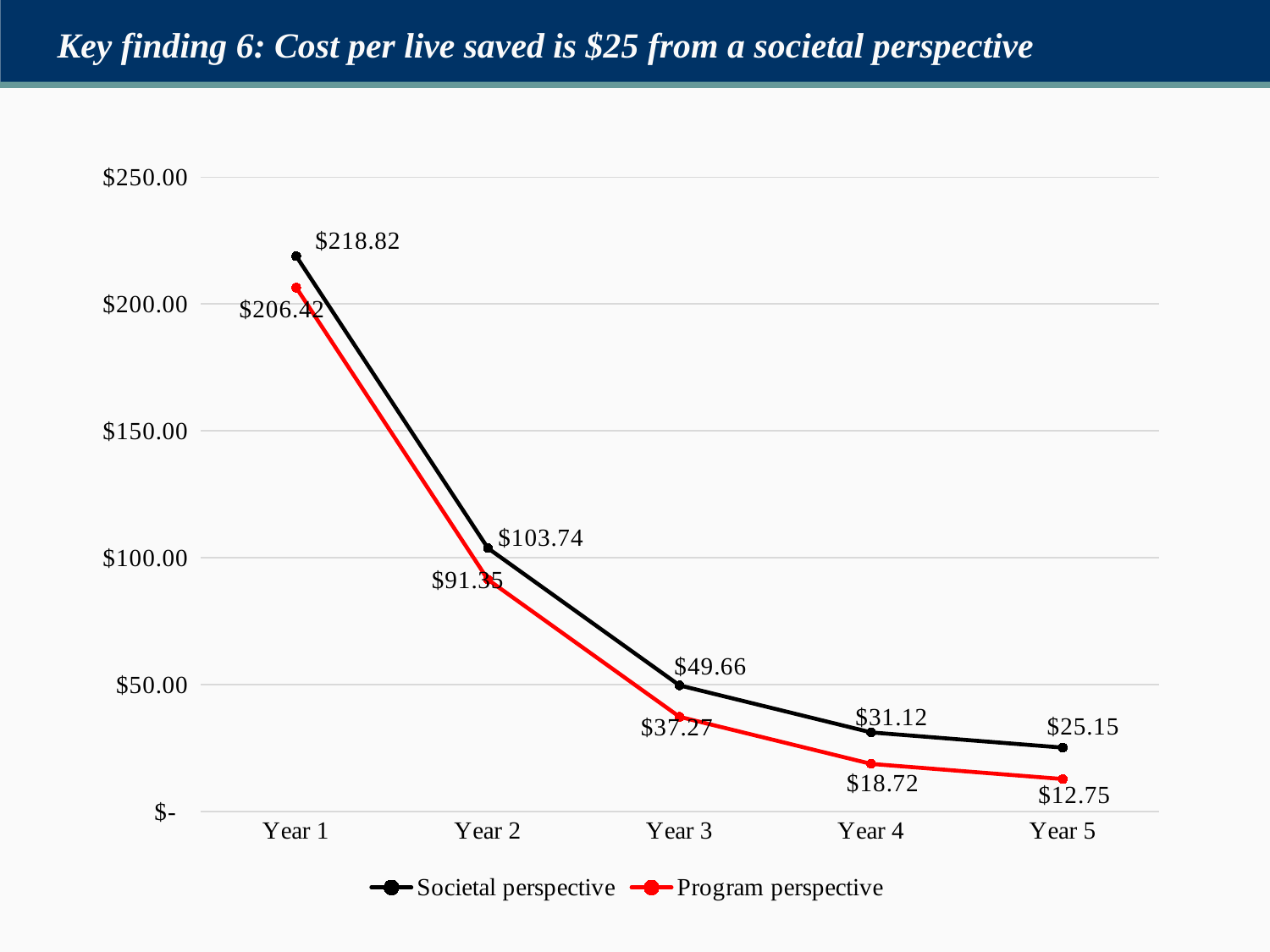
In which year is the Program perspective value lowest? Year 5 What is the Program perspective value in Year 5? $12.75 In which year is the Societal perspective value highest? Year 1 How many years are shown on the x axis? 5 Do the values rise or fall from Year 1 to Year 5? fall How many series does the legend list? 2 Is the Societal perspective value in Year 2 greater or less than $100.00? greater What is the Societal perspective cost per life saved in Year 1? $218.82 Which is larger in Year 2: the Societal perspective value or the Program perspective value? Societal perspective What is the Program perspective value in Year 4? $18.72 What is the Societal perspective value in Year 3? $49.66 What is the difference between the Societal perspective and Program perspective values in Year 5? $12.40